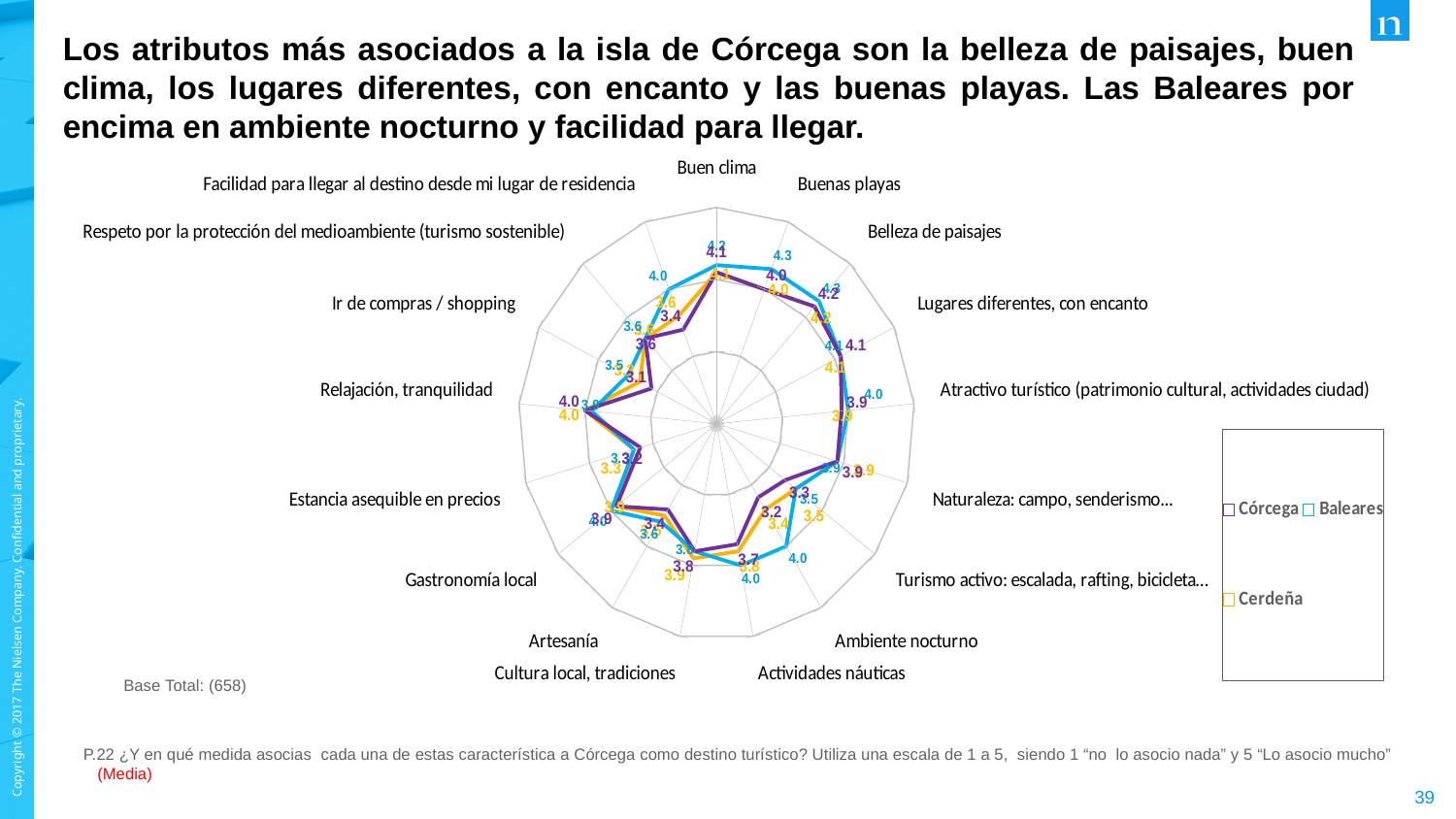
Which three destinations are listed in the chart legend? Córcega, Baleares, Cerdeña Is the value for Cerdeña on 'Turismo activo: escalada, rafting, bicicleta…' greater or less than 4? less Which is larger on 'Ambiente nocturno', Baleares or Córcega? Baleares What is the value for Baleares on 'Buenas playas'? 4.3 How many series does the legend list? 3 Is the value for Córcega on 'Estancia asequible en precios' greater or less than 4? less What is the base (sample size) shown below the chart? 658 What kind of chart is shown on the slide? Radar chart What is the value for Baleares on 'Facilidad para llegar al destino desde mi lugar de residencia'? 4.0 How many attributes (categories) are plotted around the radar chart? 17 Which is larger on 'Facilidad para llegar al destino desde mi lugar de residencia', Baleares or Córcega? Baleares What is the value for Baleares on 'Ambiente nocturno'? 4.0